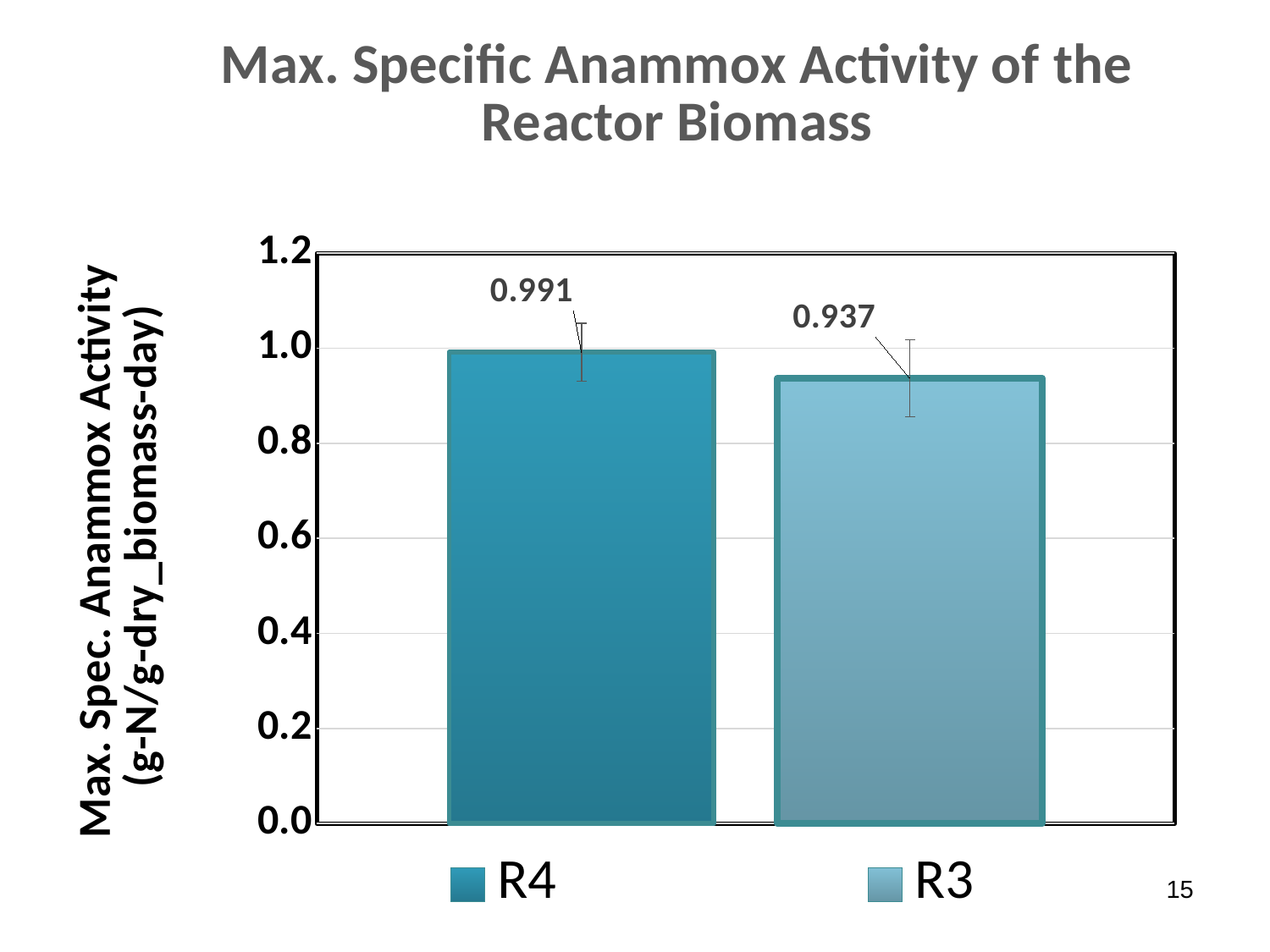
Which reactor has the higher maximum specific anammox activity? R4 Which reactor has the lower maximum specific anammox activity? R3 Is the value for R4 larger or smaller than the value for R3? larger Is the value for R3 greater or less than 1.0? less How many entries does the legend list? 2 How many bars are plotted in the chart? 2 What is the difference between the R4 and R3 maximum specific anammox activity values? 0.054 What is the maximum specific anammox activity value for R4? 0.991 What kind of chart is shown on the slide? bar chart What is the maximum specific anammox activity value for R3? 0.937 What is the label of the vertical axis? Max. Spec. Anammox Activity (g-N/g-dry_biomass-day) Is the value for R4 greater or less than 0.8? greater